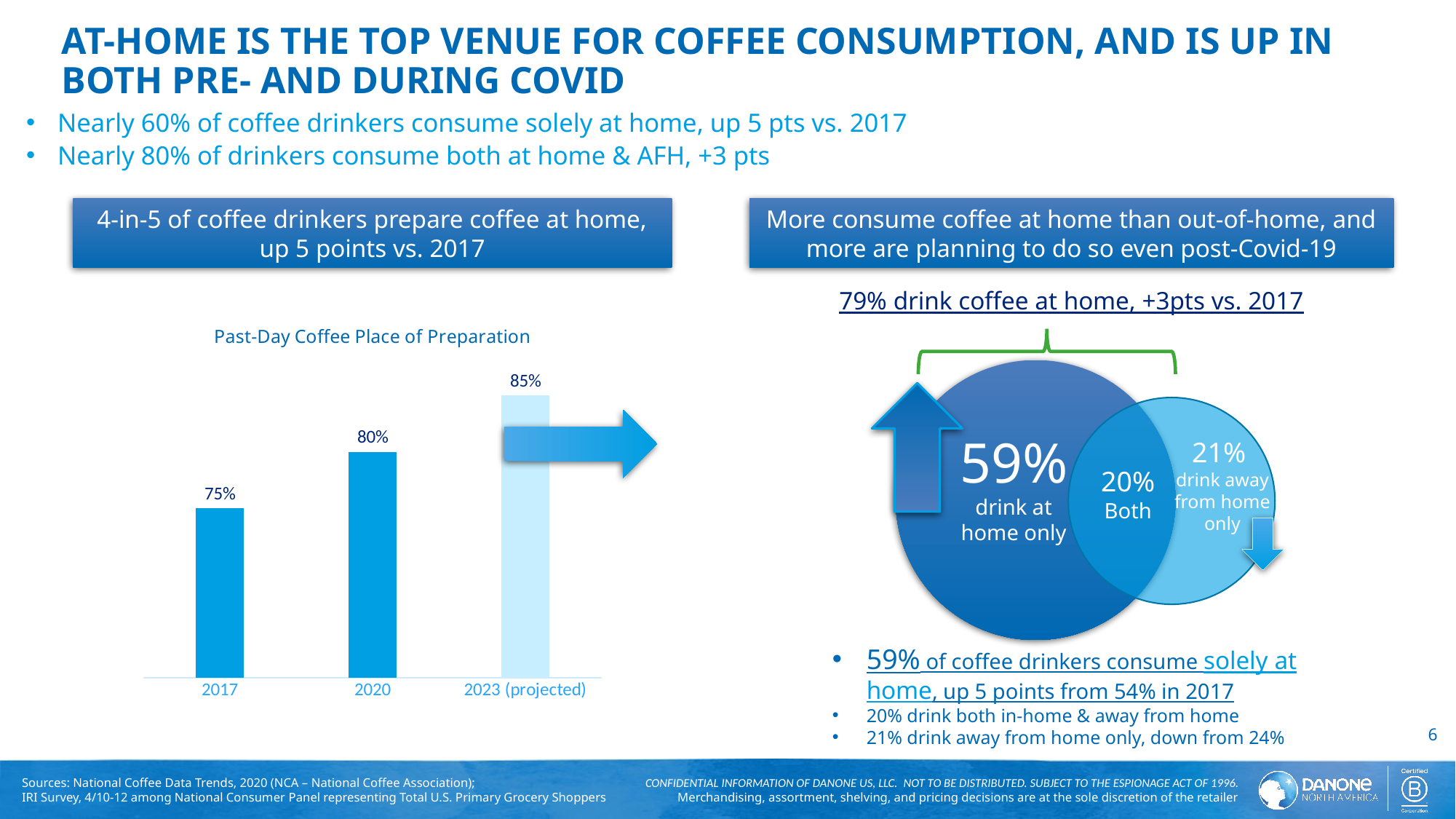
In the Venn diagram on the right of the slide, what percentage of coffee drinkers drink at home only? 59% In the 'Past-Day Coffee Place of Preparation' chart, what is the value for 2023 (projected)? 85% In the 'Past-Day Coffee Place of Preparation' chart, which year has the lowest value? 2017 In the 'Past-Day Coffee Place of Preparation' chart, what is the difference between the 2023 (projected) value and the 2017 value? 10 percentage points In the 'Past-Day Coffee Place of Preparation' chart, what is the difference between the 2020 value and the 2017 value? 5 percentage points In the 'Past-Day Coffee Place of Preparation' chart, what is the value for 2017? 75% In the 'Past-Day Coffee Place of Preparation' chart, what is the value for 2020? 80% What type of chart is 'Past-Day Coffee Place of Preparation'? Bar chart In the 'Past-Day Coffee Place of Preparation' chart, do the values rise or fall from 2017 to 2023 (projected)? Rise In the 'Past-Day Coffee Place of Preparation' chart, which year has the highest value? 2023 (projected) In the 'Past-Day Coffee Place of Preparation' chart, which is larger, the value for 2020 or the value for 2017? 2020 How many bars are shown in the 'Past-Day Coffee Place of Preparation' chart? 3